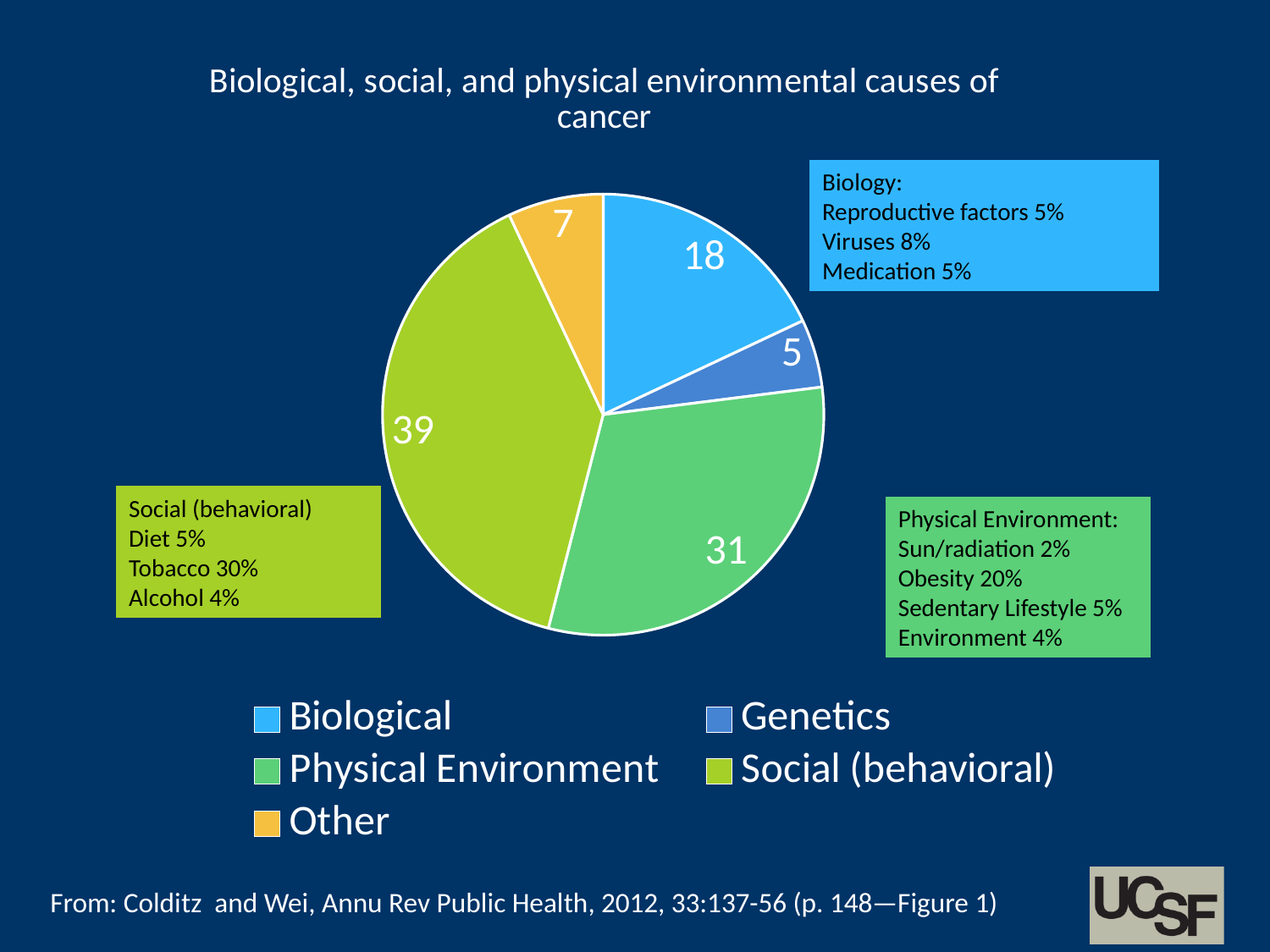
What is the value for the Other slice? 7 What is the title of the chart? Biological, social, and physical environmental causes of cancer What is the value for the Biological slice? 18 How many categories does the legend list? 5 What is the value for the Social (behavioral) slice? 39 What is the value for the Physical Environment slice? 31 Which is larger, the Biological slice or the Other slice? Biological Which category has the smallest slice of the pie? Genetics Which category has the largest slice of the pie? Social (behavioral) What is the difference between the Social (behavioral) and Physical Environment values? 8 What is the value for the Genetics slice? 5 What type of chart is shown on the slide? pie chart